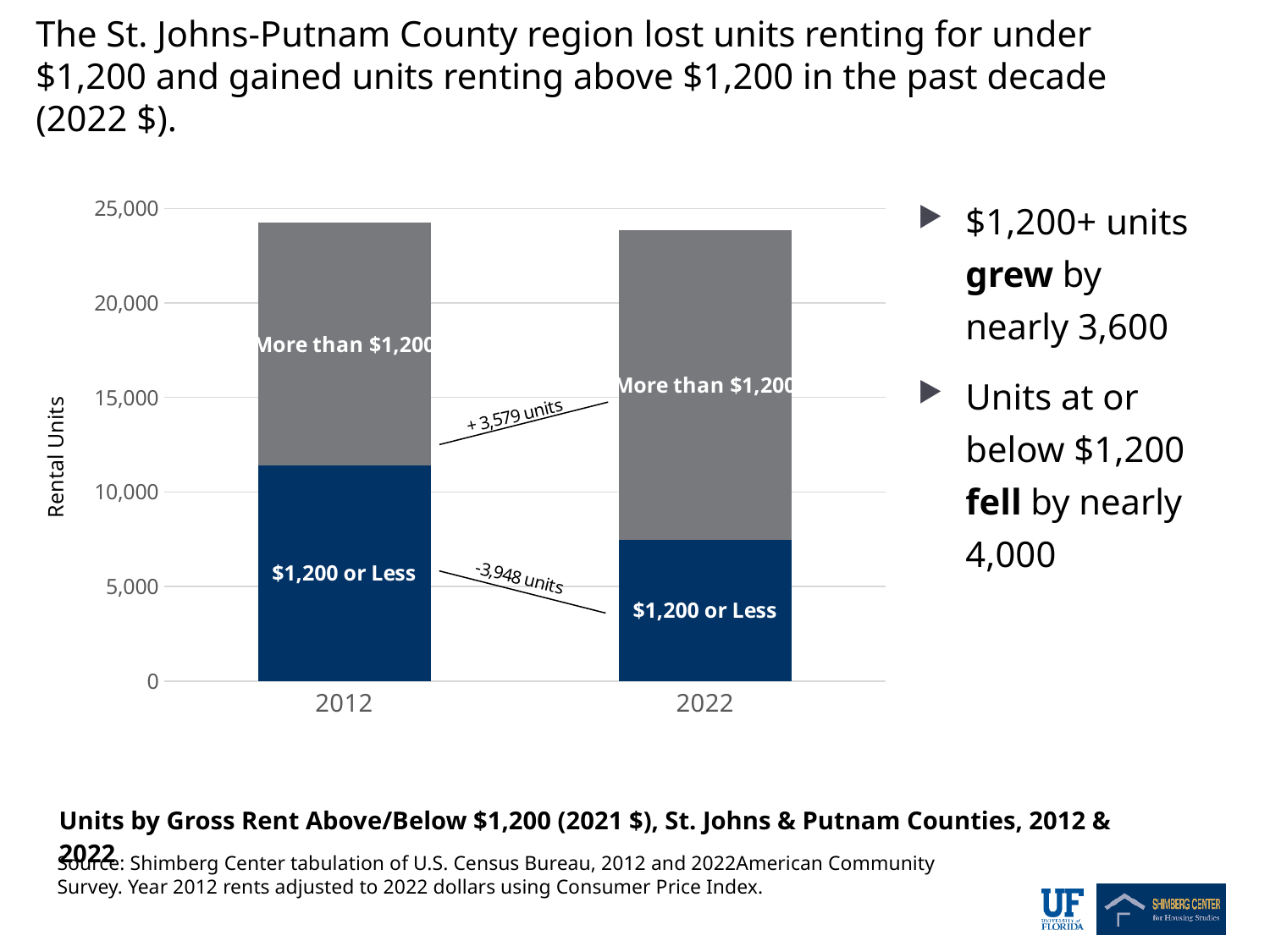
What kind of chart is shown on the slide? Stacked bar chart Which year has the larger 'More than $1,200' segment, 2012 or 2022? 2022 Is the total height of the 2012 bar greater or less than 20,000? greater What is the label on the y axis of the chart? Rental Units Which year has the larger '$1,200 or Less' segment, 2012 or 2022? 2012 According to the annotation on the chart, by how many units did the 'More than $1,200' category change between 2012 and 2022? + 3,579 units Is the value for '$1,200 or Less' in 2012 greater or less than 10,000? greater How many years (bars) are shown on the x axis of the chart? 2 Does the '$1,200 or Less' segment rise or fall from 2012 to 2022? Fall Is the value for '$1,200 or Less' in 2022 greater or less than 10,000? less How many rent categories are stacked in each bar of the chart? 2 According to the annotation on the chart, by how many units did the '$1,200 or Less' category change between 2012 and 2022? -3,948 units